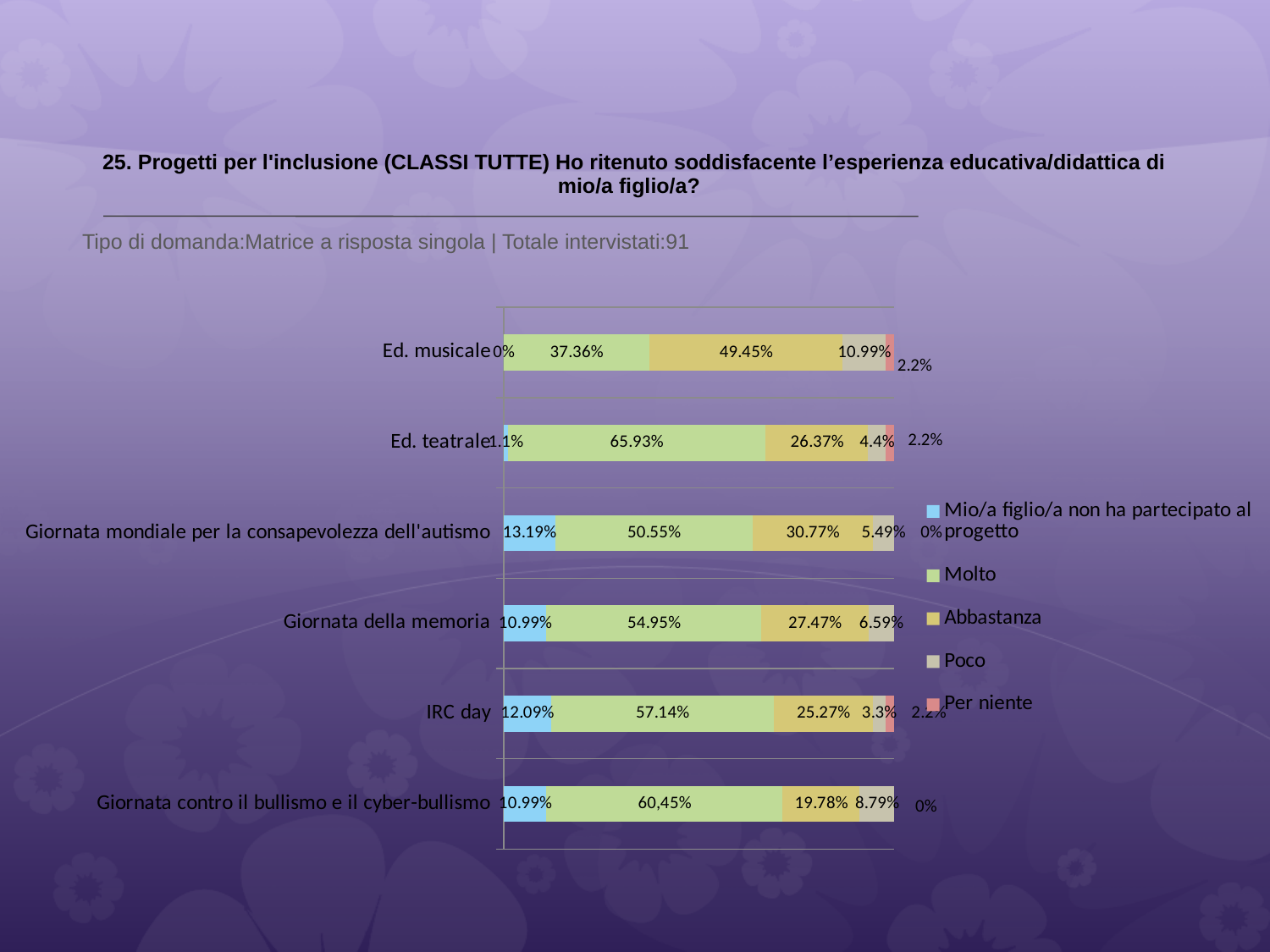
Which is larger: the 'Abbastanza' value for Giornata mondiale per la consapevolezza dell'autismo or for IRC day? Giornata mondiale per la consapevolezza dell'autismo What type of chart is shown on the slide? Stacked bar chart What is the total number of respondents stated on the slide? 91 Which category has the lowest 'Molto' value? Ed. musicale How many series does the legend list? 5 What is the difference between the 'Molto' values for IRC day and Giornata della memoria? 2.19% Which category has the highest 'Molto' value? Ed. teatrale What is the 'Poco' value for Giornata contro il bullismo e il cyber-bullismo? 8.79% What is the 'Abbastanza' value for Ed. musicale? 49.45% What is the 'Molto' value for Ed. teatrale? 65.93% How many categories (projects) are shown on the chart? 6 What is the 'Mio/a figlio/a non ha partecipato al progetto' value for Giornata mondiale per la consapevolezza dell'autismo? 13.19%